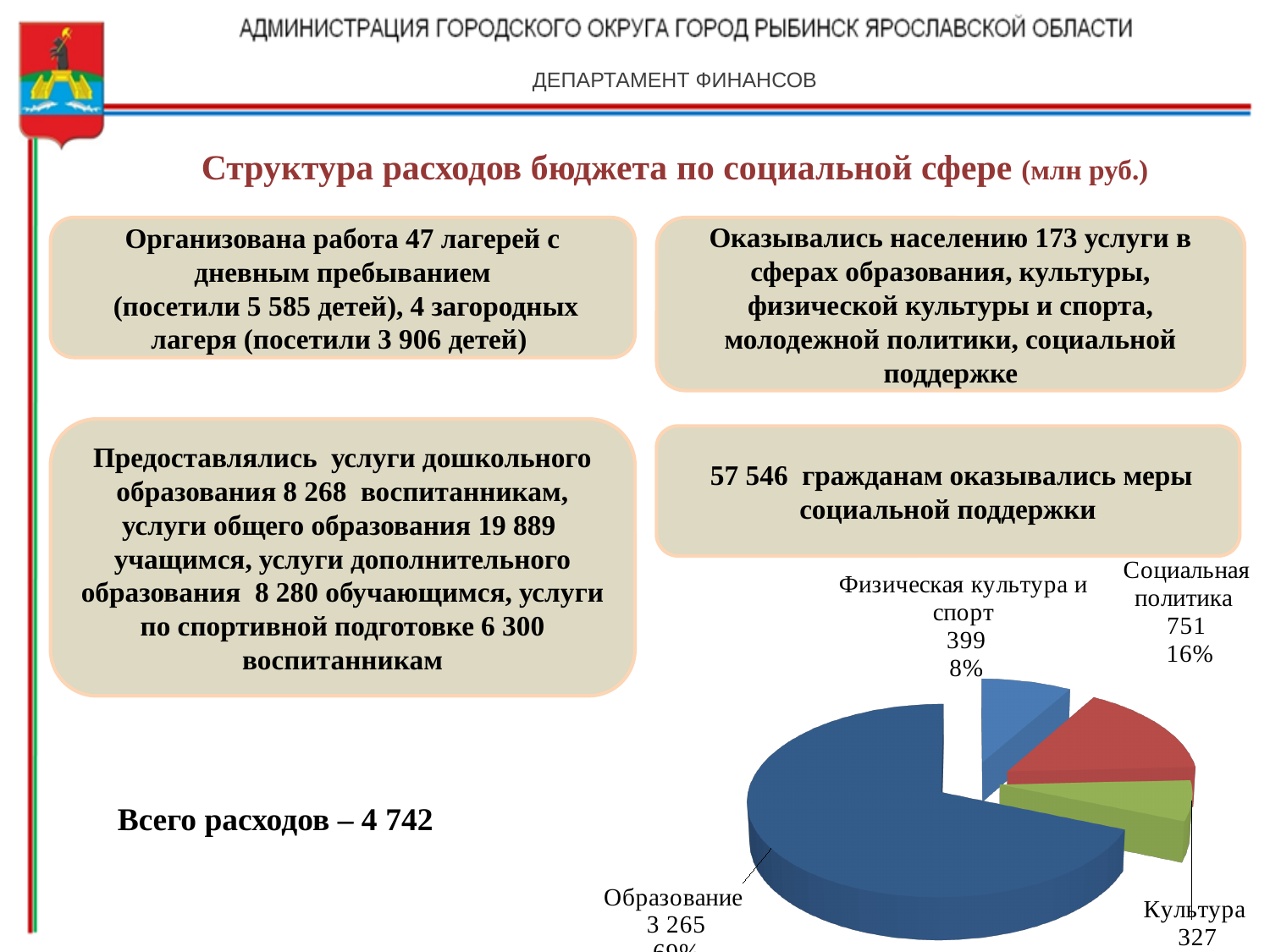
What is the value for Образование in the pie chart? 3 265 Which is larger in the pie chart: Физическая культура и спорт or Культура? Физическая культура и спорт What share of the pie does Физическая культура и спорт represent? 8% What is the value for Культура in the pie chart? 327 What is the value for Социальная политика in the pie chart? 751 What kind of chart is shown on the slide? pie chart Which category has the smallest slice in the pie chart? Культура What is the difference between the values for Социальная политика and Физическая культура и спорт? 352 Which category has the largest slice in the pie chart? Образование How many slices does the pie chart have? 4 What share of the pie does Социальная политика represent? 16% What is the value for Физическая культура и спорт in the pie chart? 399